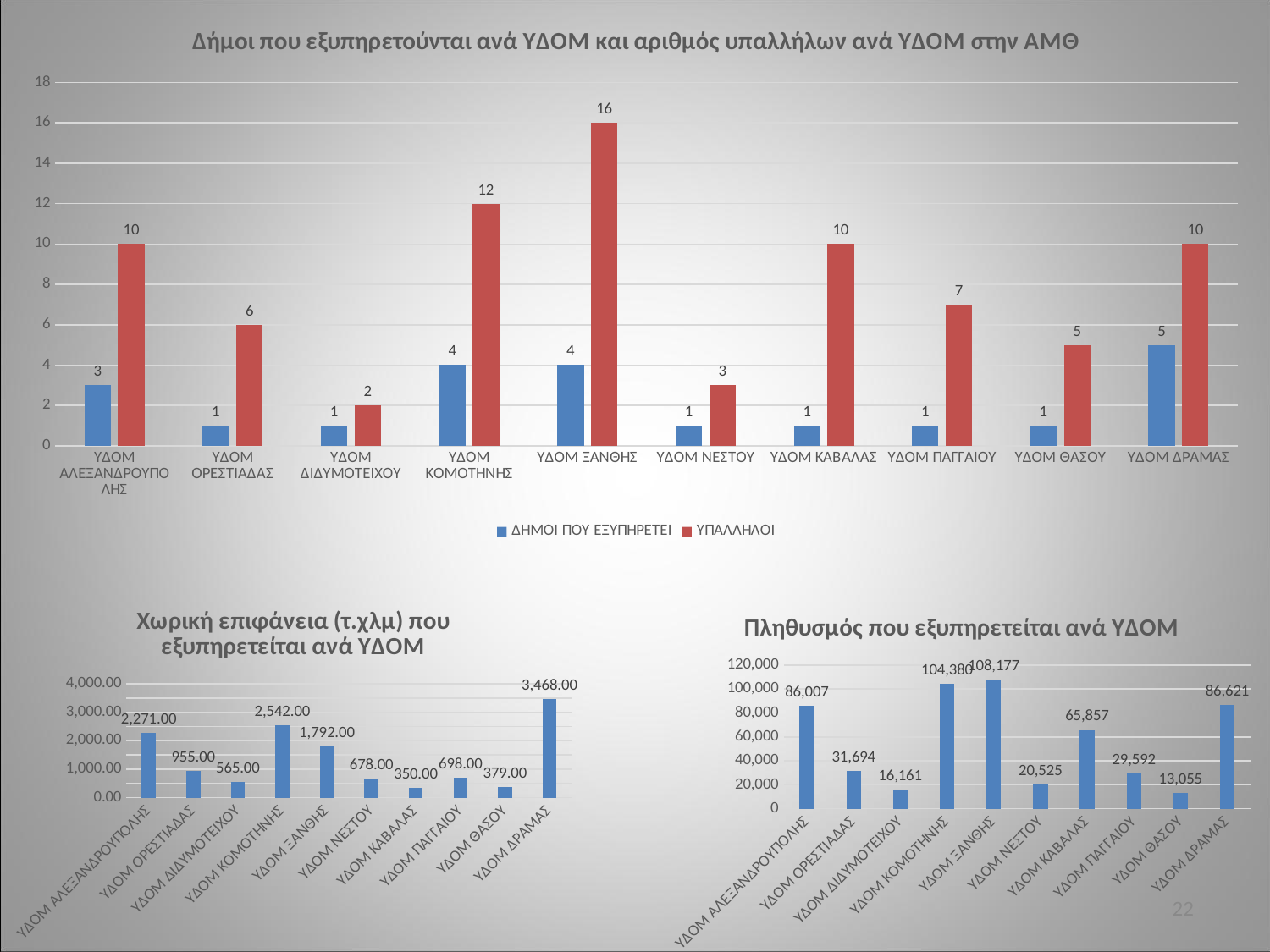
In the top chart, which ΥΔΟΜ has the lowest number of ΥΠΑΛΛΗΛΟΙ? ΥΔΟΜ ΔΙΔΥΜΟΤΕΙΧΟΥ In the chart titled 'Χωρική επιφάνεια (τ.χλμ) που εξυπηρετείται ανά ΥΔΟΜ', what is the value for ΥΔΟΜ ΞΑΝΘΗΣ? 1,792.00 In the top chart, how many ΥΠΑΛΛΗΛΟΙ does ΥΔΟΜ ΞΑΝΘΗΣ have? 16 In the chart titled 'Πληθυσμός που εξυπηρετείται ανά ΥΔΟΜ', which ΥΔΟΜ has the largest population? ΥΔΟΜ ΞΑΝΘΗΣ In the chart titled 'Πληθυσμός που εξυπηρετείται ανά ΥΔΟΜ', which is larger: the value for ΥΔΟΜ ΟΡΕΣΤΙΑΔΑΣ or ΥΔΟΜ ΠΑΓΓΑΙΟΥ? ΥΔΟΜ ΟΡΕΣΤΙΑΔΑΣ How many ΥΔΟΜ categories are shown in the top chart? 10 In the top chart, what is the difference in ΥΠΑΛΛΗΛΟΙ between ΥΔΟΜ ΚΟΜΟΤΗΝΗΣ and ΥΔΟΜ ΟΡΕΣΤΙΑΔΑΣ? 6 What type of chart is the bottom-right chart titled 'Πληθυσμός που εξυπηρετείται ανά ΥΔΟΜ'? Bar chart In the chart titled 'Πληθυσμός που εξυπηρετείται ανά ΥΔΟΜ', what is the population for ΥΔΟΜ ΚΑΒΑΛΑΣ? 65,857 How many series does the legend of the top chart list? 2 In the top chart, which ΥΔΟΜ has the highest value for ΔΗΜΟΙ ΠΟΥ ΕΞΥΠΗΡΕΤΕΙ? ΥΔΟΜ ΔΡΑΜΑΣ In the chart titled 'Χωρική επιφάνεια (τ.χλμ) που εξυπηρετείται ανά ΥΔΟΜ', which ΥΔΟΜ has the smallest area? ΥΔΟΜ ΚΑΒΑΛΑΣ